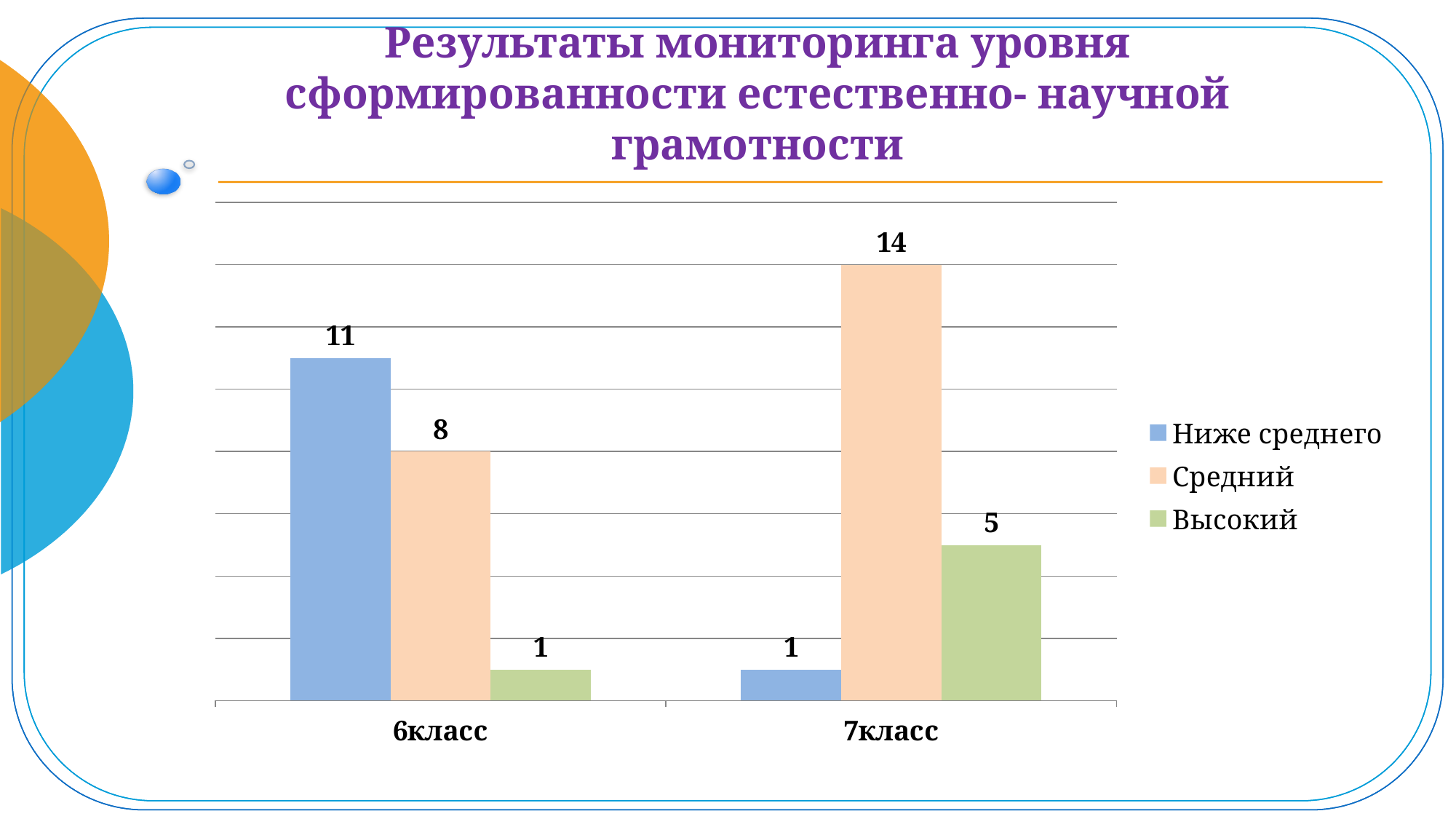
Which is larger: Ниже среднего in 6класс or Высокий in 7класс? Ниже среднего in 6класс How many categories are shown on the x axis? 2 How many series does the legend list? 3 Does the Высокий value rise or fall from 6класс to 7класс? Rise What kind of chart is shown on the slide? Bar chart What is the value for Ниже среднего in 6класс? 11 What is the difference between the Средний values for 7класс and 6класс? 6 What is the value for Средний in 7класс? 14 Which series has the highest value in 7класс? Средний What is the value for Высокий in 6класс? 1 Which series has the lowest value in 6класс? Высокий What is the value for Ниже среднего in 7класс? 1